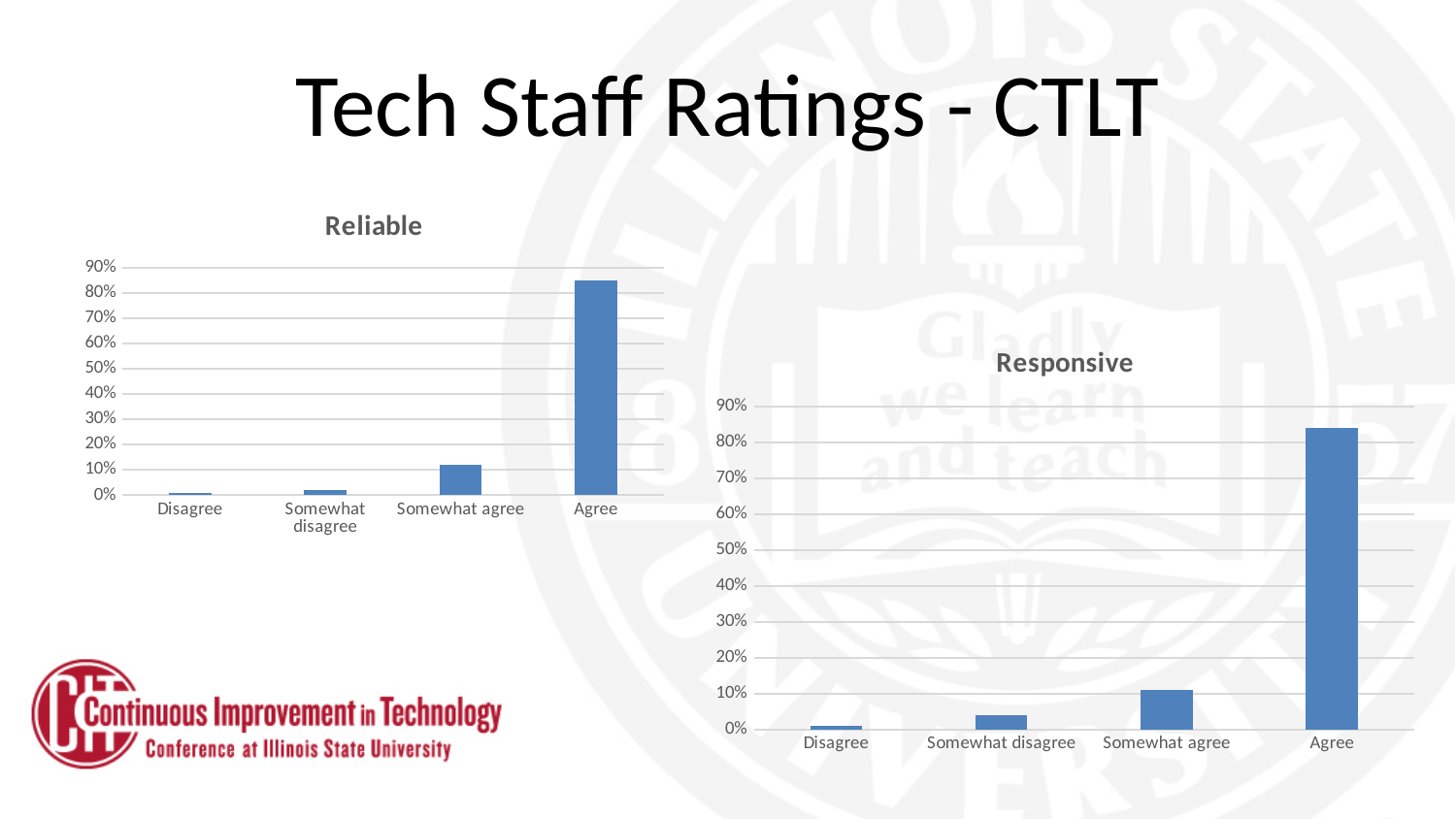
In the Responsive chart, which category has the lowest value? Disagree In the Reliable chart, which category has the highest value? Agree In the Responsive chart, is the value for Agree greater or less than 80%? greater In the Responsive chart, which category has the highest value? Agree In the Reliable chart, which is larger, the value for Somewhat agree or the value for Somewhat disagree? Somewhat agree In the Responsive chart, which is larger, the value for Agree or the value for Somewhat agree? Agree In the Reliable chart, do the values rise or fall from Disagree to Agree along the x axis? rise In the Reliable chart, is the value for Agree greater or less than 80%? greater How many categories are shown on the x axis of the Reliable chart? 4 What kind of chart is the Responsive chart? bar chart In the Responsive chart, is the value for Somewhat disagree greater or less than 10%? less